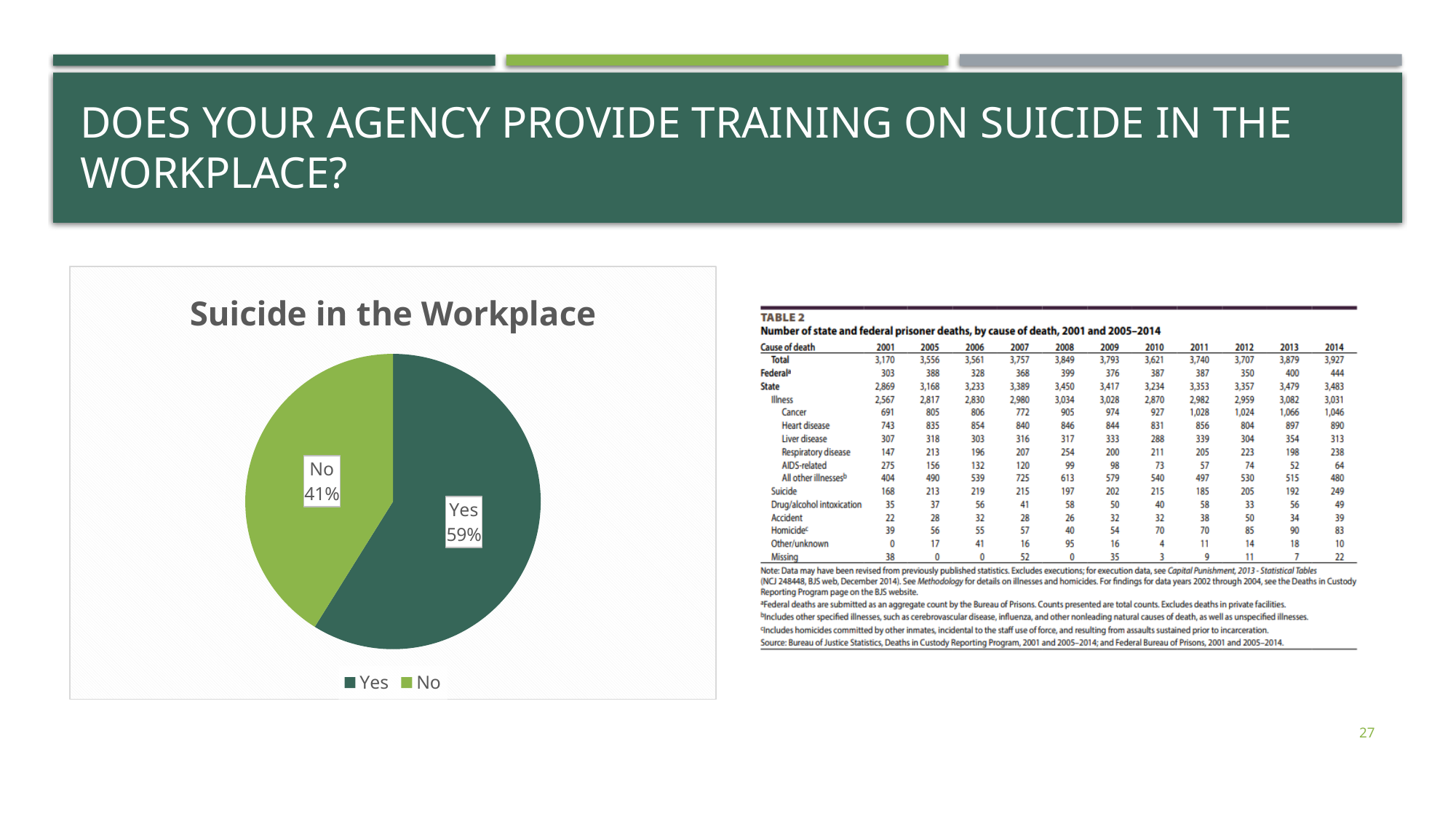
In the 'Suicide in the Workplace' pie chart, what share of respondents answered No? 41% In the 'Suicide in the Workplace' pie chart, what is the difference in percentage points between the Yes and No slices? 18 How many slices does the 'Suicide in the Workplace' pie chart have? 2 In the 'Suicide in the Workplace' pie chart, which slice is the largest? Yes What kind of chart is 'Suicide in the Workplace'? pie chart In the 'Suicide in the Workplace' pie chart, what colour is the No slice? light green How many entries does the legend of the 'Suicide in the Workplace' pie chart list? 2 What is the title of the pie chart on the slide? Suicide in the Workplace In the 'Suicide in the Workplace' pie chart, which is larger, the Yes slice or the No slice? Yes In the 'Suicide in the Workplace' pie chart, what share of respondents answered Yes? 59% In the 'Suicide in the Workplace' pie chart, which slice is the smallest? No